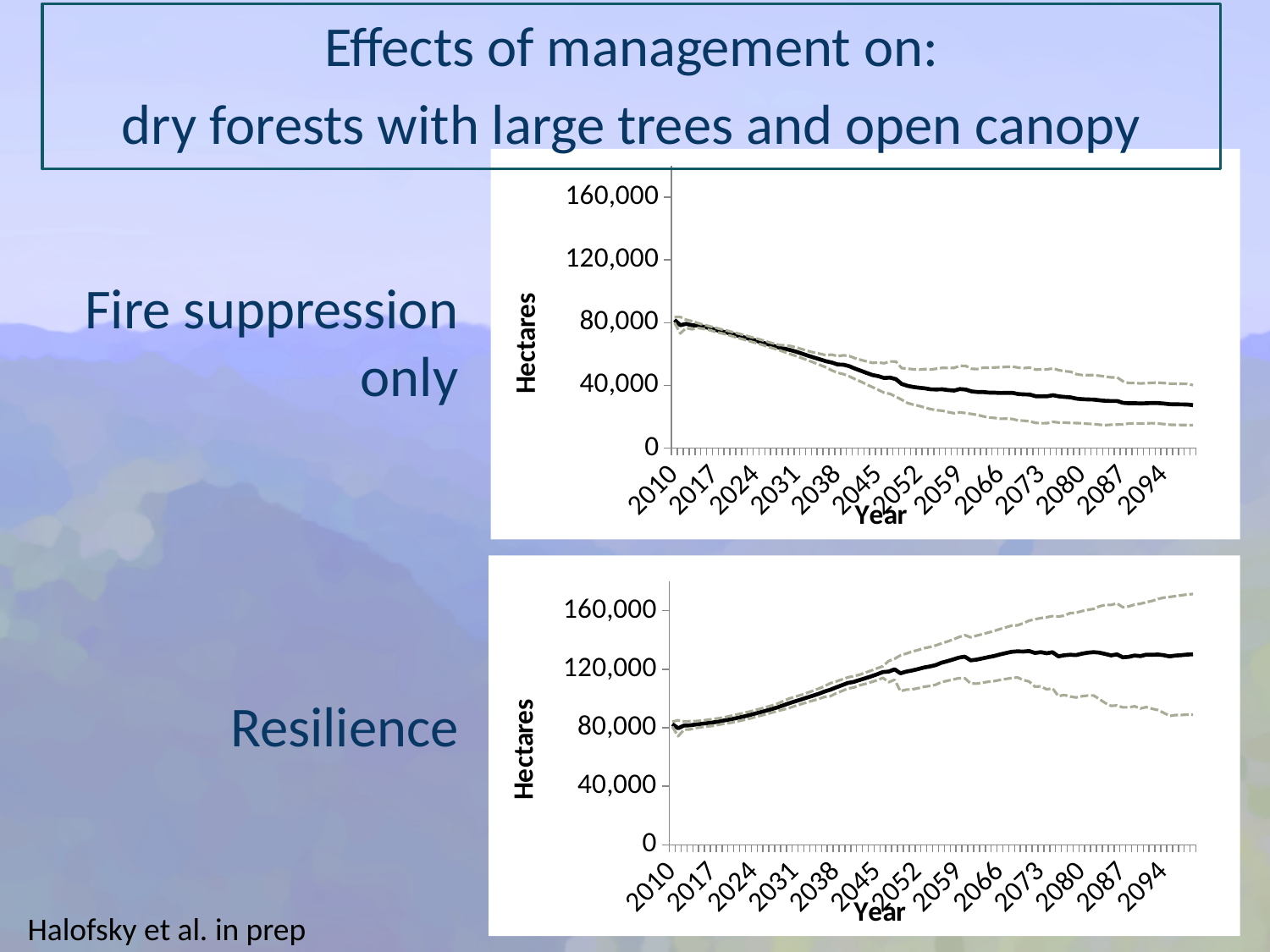
In the Fire suppression only chart, is the solid line's value at 2038 greater or less than 80,000 hectares? less At 2094, which chart shows the higher solid-line value: Fire suppression only or Resilience? Resilience What is the x-axis title of the Fire suppression only chart? Year In the Resilience chart, is the solid line's value at 2094 greater or less than 120,000 hectares? greater In the Fire suppression only chart, does the solid line rise or fall from 2010 to 2094? fall What is the y-axis title of the Resilience chart? Hectares In the Resilience chart, is the solid line's value at 2031 greater or less than 80,000 hectares? greater In the Resilience chart, does the solid line rise or fall from 2010 to 2094? rise How many year labels are shown on the x axis of the Fire suppression only chart? 13 What kind of chart is the bottom chart (Resilience)? line chart What kind of chart is the top chart (Fire suppression only)? line chart